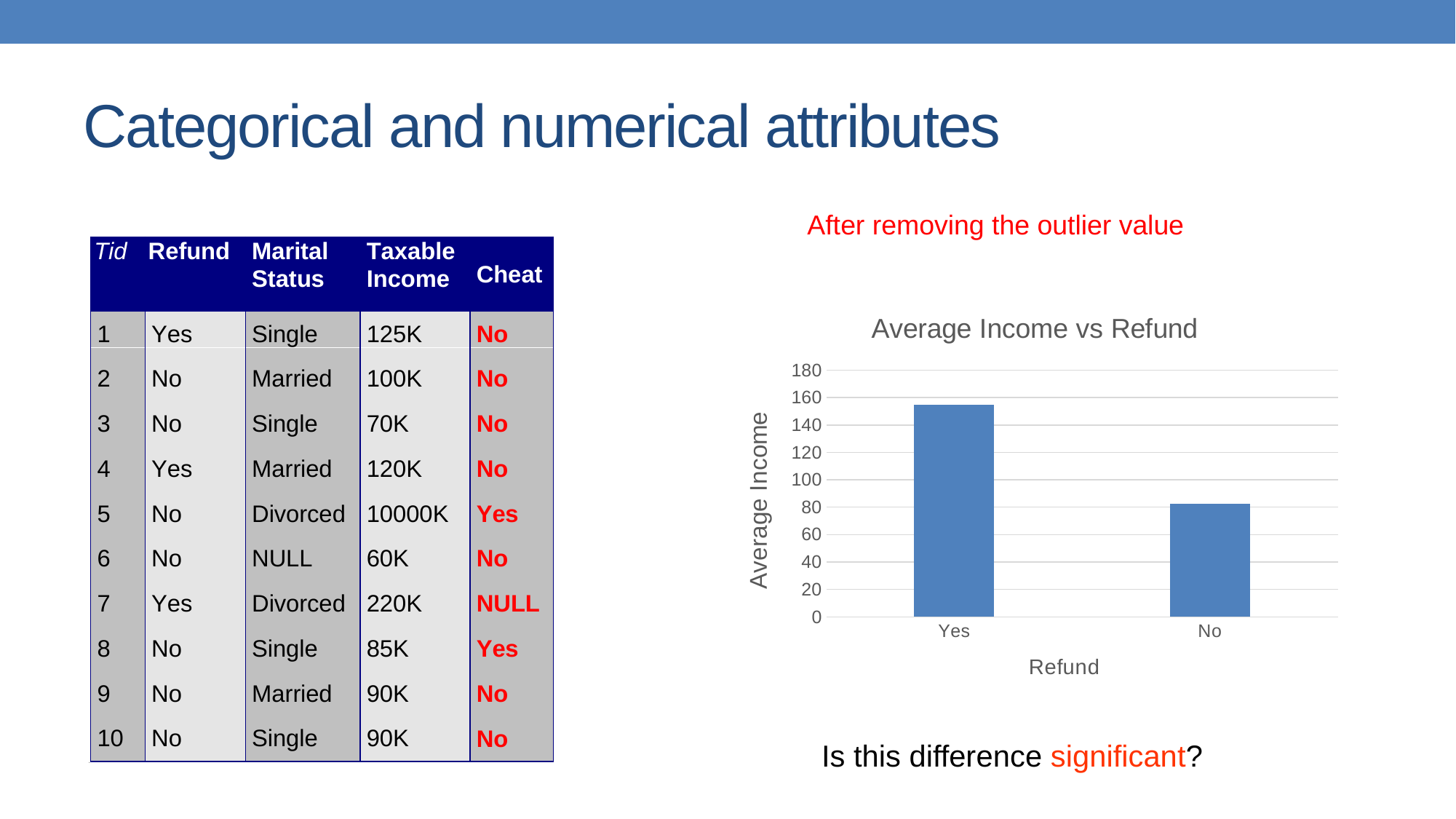
What kind of chart is shown on the slide? bar chart Is the average income for Refund = Yes greater or less than 140? greater What is the title of the chart? Average Income vs Refund Is the average income for Refund = No greater or less than 60? greater Which has a larger average income in the chart, Refund = Yes or Refund = No? Yes Which Refund category has the highest average income in the chart? Yes What is the label of the y axis of the chart? Average Income Is the average income for Refund = Yes greater or less than 180? less How many categories are plotted on the x axis of the chart? 2 Which Refund category has the lowest average income in the chart? No